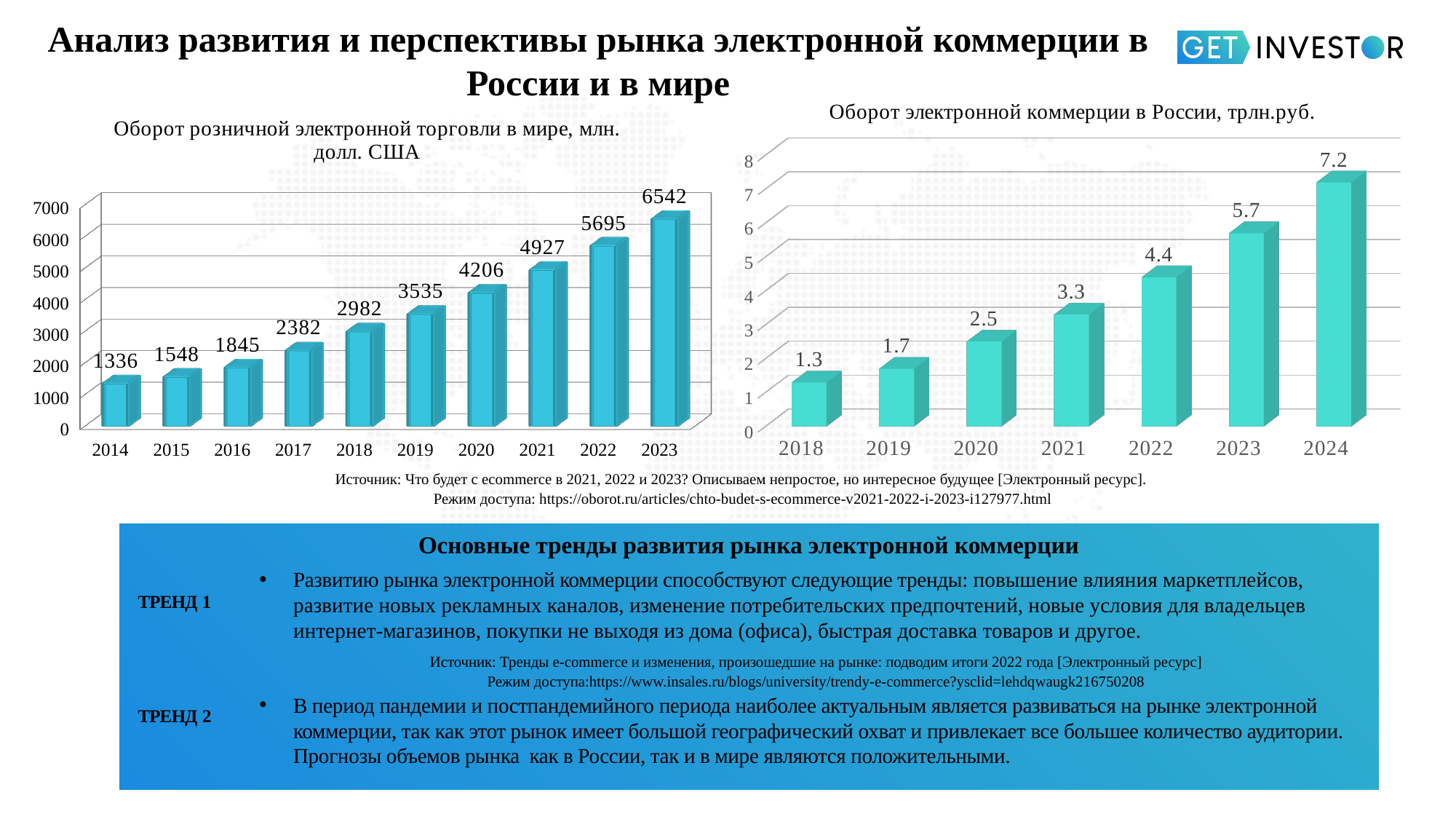
In the left chart (Оборот розничной электронной торговли в мире), which year has the highest value? 2023 In the left chart (Оборот розничной электронной торговли в мире), how many years are shown on the x axis? 10 In the right chart (Оборот электронной коммерции в России), what is the difference between the values for 2024 and 2023? 1.5 In the right chart (Оборот электронной коммерции в России), which year has the lowest value? 2018 In the right chart (Оборот электронной коммерции в России), what is the value for 2021? 3.3 In the right chart (Оборот электронной коммерции в России), how many years are shown on the x axis? 7 What type of chart is the right chart (Оборот электронной коммерции в России)? Bar chart In the left chart (Оборот розничной электронной торговли в мире), what is the difference between the values for 2023 and 2022? 847 In the right chart (Оборот электронной коммерции в России), do the values rise or fall from 2018 to 2024? Rise What unit is given in the title of the right chart? трлн.руб. In the left chart (Оборот розничной электронной торговли в мире), what is the value for 2018? 2982 In the left chart (Оборот розничной электронной торговли в мире), which is larger: the value for 2019 or the value for 2020? 2020